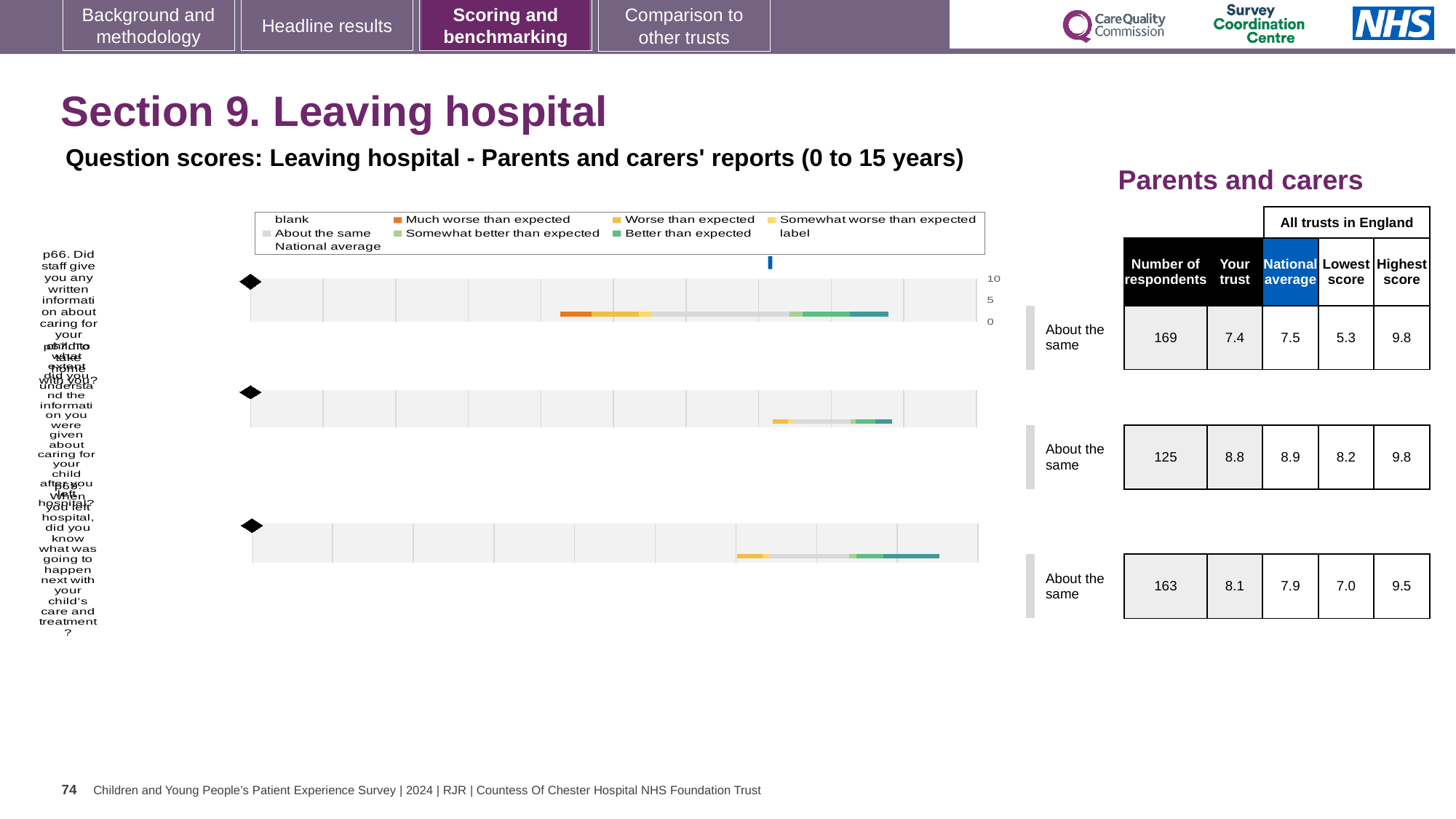
In the legend, which colour represents 'Much worse than expected'? orange For the second chart, what is the difference between the highest score and the lowest score across all trusts in England? 1.6 How many question score charts are shown on the slide? 3 What benchmark category is shown next to each of the three charts? About the same What kind of chart is used to show the question scores on this slide? bar chart For the first chart (p66), what is the national average shown in the table? 7.5 For the first chart (p66), what is the 'Your trust' score shown in the table? 7.4 What is the maximum value shown on the score axis at the top right of the charts? 10 For the third chart (p68), what is the 'Your trust' score shown in the table? 8.1 For the third chart (p68), is the 'Your trust' score higher or lower than the national average? higher For the second chart, what is the number of respondents shown in the table? 125 How many entries does the legend above the charts list? 9